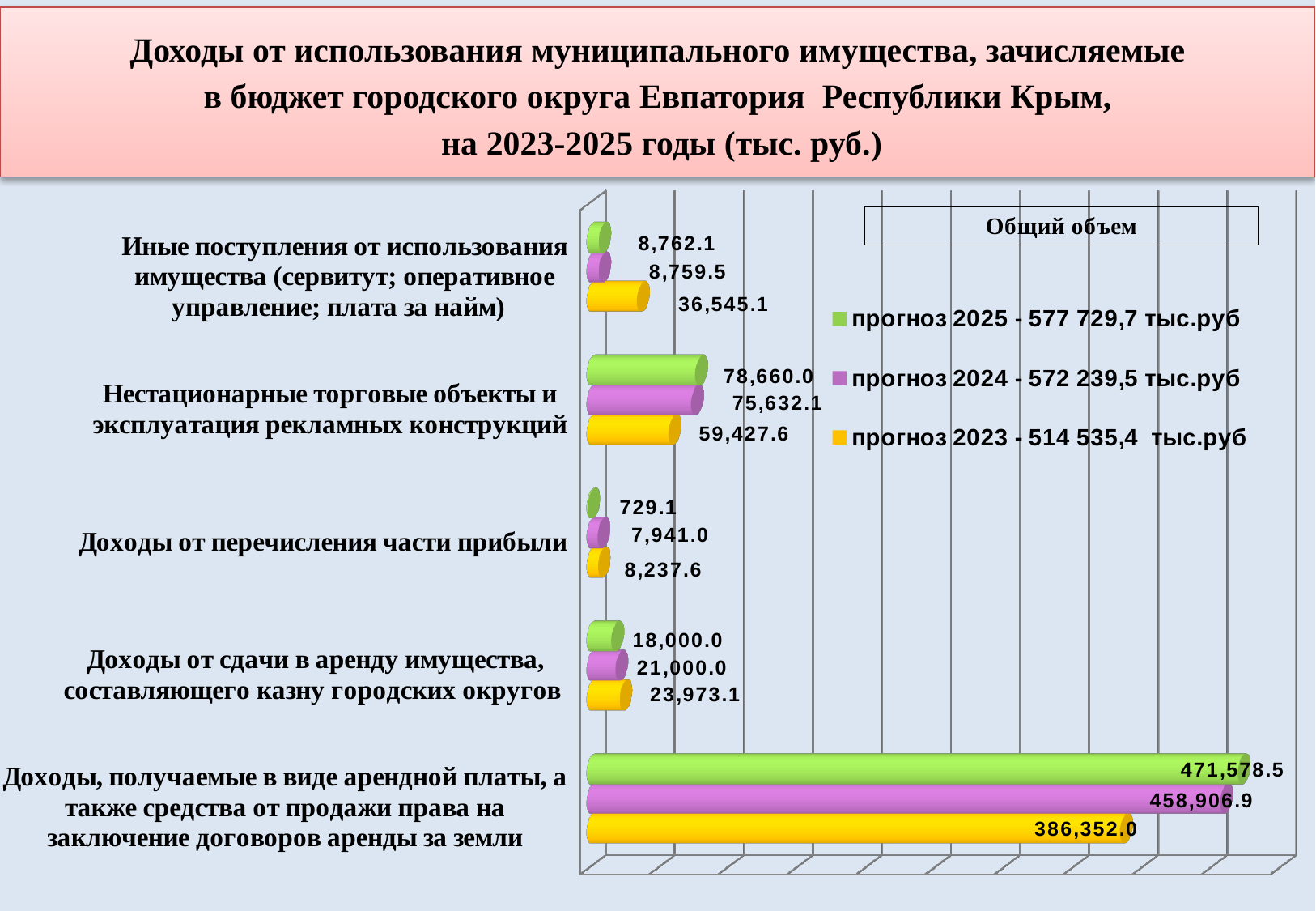
How many categories are shown on the chart? 5 What is the прогноз 2025 value for «Доходы от перечисления части прибыли»? 729.1 What is the прогноз 2025 value for «Доходы, получаемые в виде арендной платы, а также средства от продажи права на заключение договоров аренды за земли»? 471,578.5 What is the difference between the прогноз 2025 and прогноз 2023 values for «Доходы, получаемые в виде арендной платы, а также средства от продажи права на заключение договоров аренды за земли»? 85,226.5 What is the прогноз 2024 value for «Нестационарные торговые объекты и эксплуатация рекламных конструкций»? 75,632.1 What is the прогноз 2023 value for «Иные поступления от использования имущества (сервитут; оперативное управление; плата за найм)»? 36,545.1 Which category has the highest прогноз 2024 value? Доходы, получаемые в виде арендной платы, а также средства от продажи права на заключение договоров аренды за земли What is the difference between the прогноз 2023 and прогноз 2025 values for «Доходы от сдачи в аренду имущества, составляющего казну городских округов»? 5,973.1 Which category has the lowest прогноз 2025 value? Доходы от перечисления части прибыли How many series does the legend list? 3 What kind of chart is shown on the slide? Bar chart For «Нестационарные торговые объекты и эксплуатация рекламных конструкций», which is larger: the прогноз 2025 value or the прогноз 2023 value? прогноз 2025